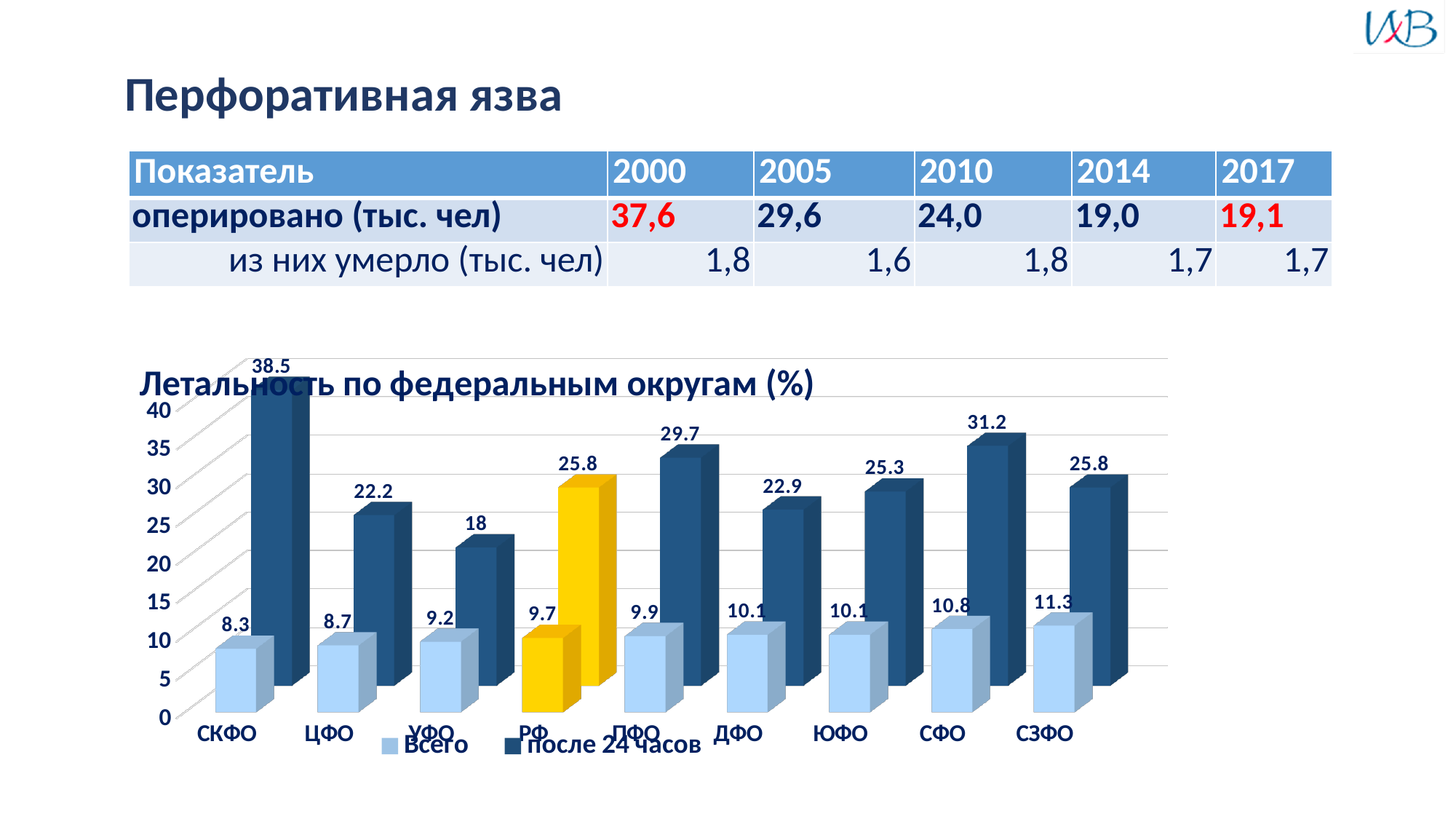
What is the chart's title? Летальность по федеральным округам (%) Do the 'Всего' values rise or fall moving from СКФО to СЗФО along the x axis? rise How many series does the chart legend list? 2 What is the value of 'Всего' for РФ? 9.7 What type of chart is shown on the slide? bar chart How many federal districts (categories) are shown on the x axis of the chart? 9 What is the value of 'после 24 часов' for СКФО? 38.5 What is the value of 'после 24 часов' for УФО? 18 Which is larger: the 'после 24 часов' value for ЦФО or for ДФО? ДФО What is the difference between the 'после 24 часов' value for СФО and for ПФО? 1.5 Which district has the highest 'после 24 часов' value? СКФО Which district has the lowest 'Всего' value? СКФО